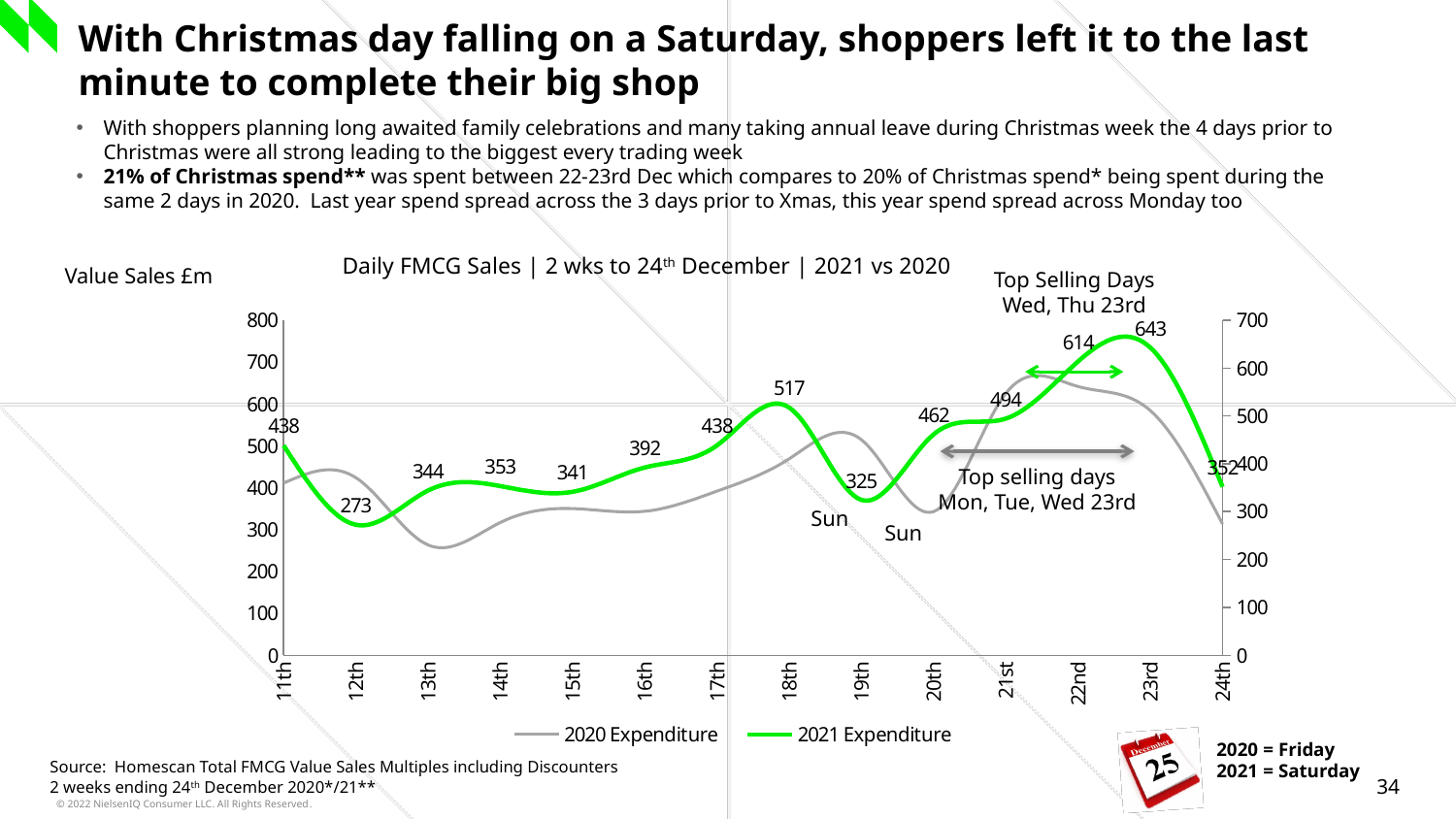
Is the 2020 Expenditure value on the 13th greater or less than 300? less What is the difference between the 2021 Expenditure values on the 23rd and the 22nd? 29 What is the 2021 Expenditure value on the 12th? 273 What is the difference between the 2021 Expenditure values on the 18th and the 19th? 192 On which day does the 2021 Expenditure line reach its highest value? 23rd What is the 2021 Expenditure value on the 18th? 517 How many days are shown on the x axis of the chart? 14 How many series does the chart legend list? 2 On which day does the 2021 Expenditure line reach its lowest value? 12th What kind of chart is shown on the slide? line chart Which is larger for 2021 Expenditure: the value on the 11th or the value on the 12th? 11th What is the 2021 Expenditure value on the 23rd? 643